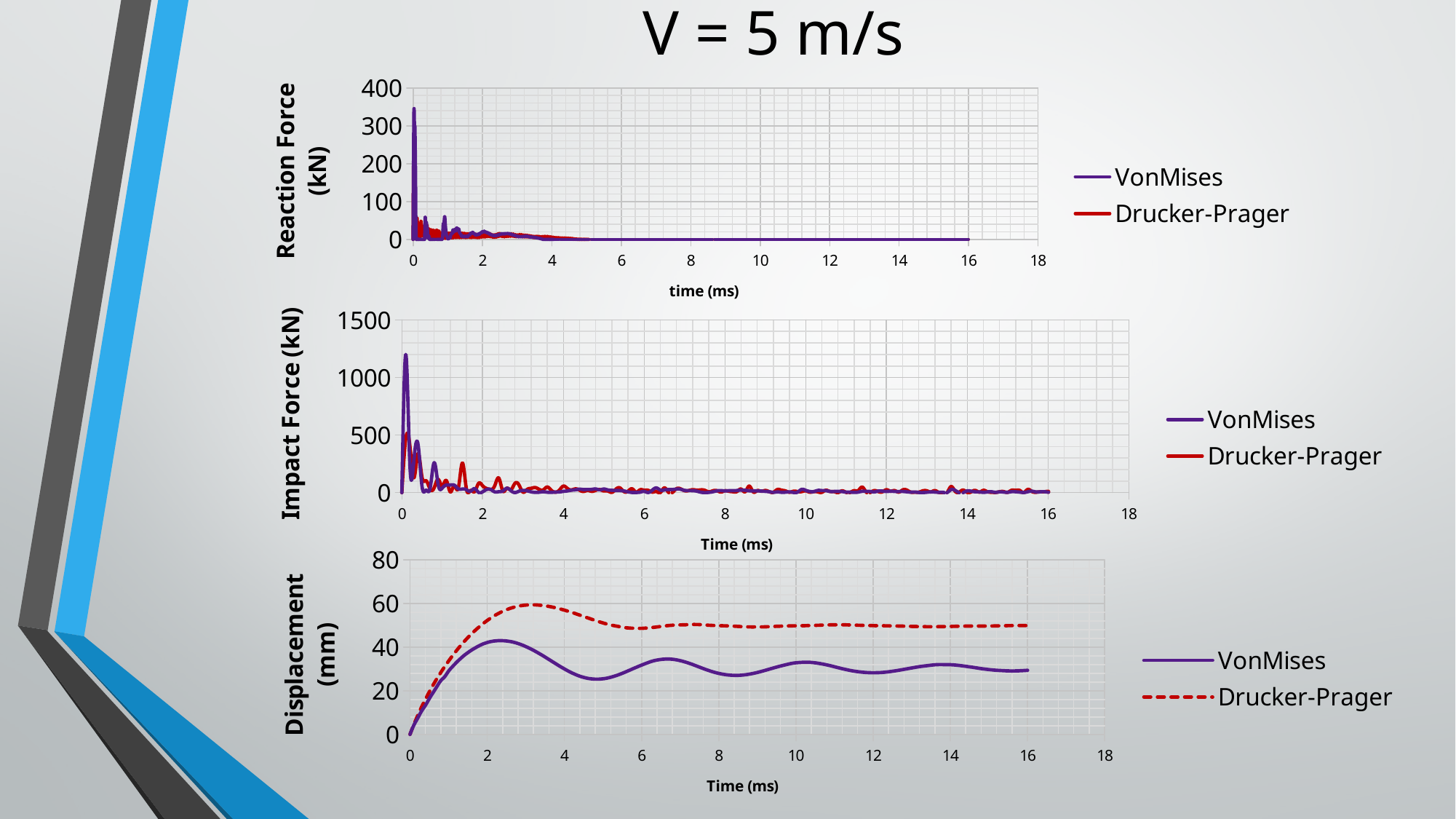
What kind of chart is the Displacement (mm) chart at the bottom of the slide? line chart How many charts are shown on the slide? 3 In the Displacement (mm) chart, is the peak value of the VonMises series greater or less than 60? less In the Impact Force (kN) chart, is the peak value greater or less than 1000? greater In the Displacement (mm) chart, does the VonMises series rise or fall between 0 and 2 ms? rise In the Displacement (mm) chart, is the peak value of the Drucker-Prager series greater or less than 40? greater In the Displacement (mm) chart, which series has the larger value at 16 ms, VonMises or Drucker-Prager? Drucker-Prager In the Displacement (mm) chart, which series reaches the highest value? Drucker-Prager What is the x-axis label of the Displacement (mm) chart? Time (ms) In the Displacement (mm) chart, which series is drawn with a dashed line? Drucker-Prager How many series does the legend of the Reaction Force (kN) chart list? 2